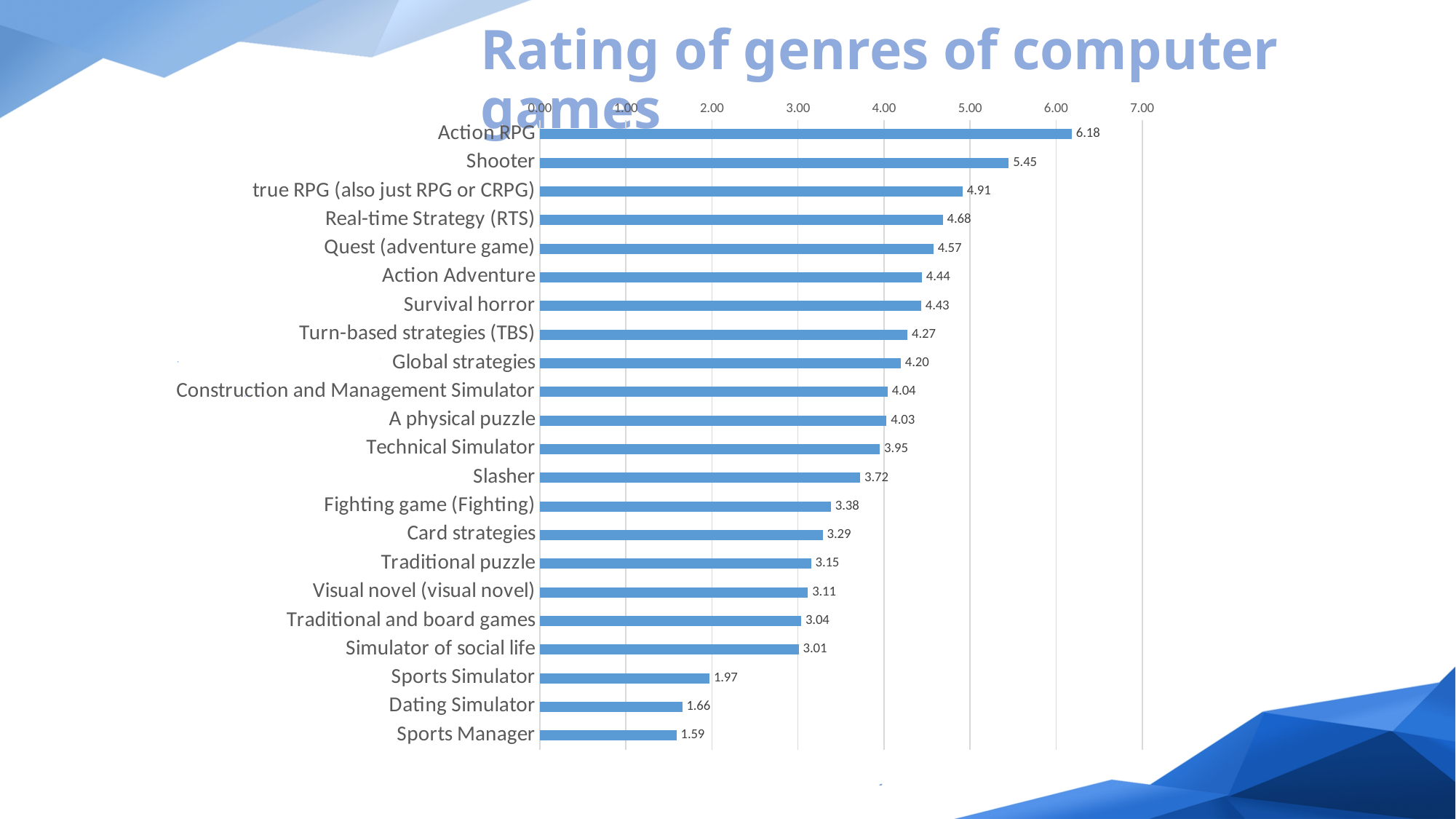
What is the rating for Survival horror? 4.43 Is the rating for Technical Simulator greater or less than 4.00? less What is the title of the chart? Rating of genres of computer games Which has a higher rating, Slasher or Card strategies? Slasher How many genres are shown in the chart? 22 What is the difference between the ratings of Sports Simulator and Sports Manager? 0.38 What is the rating for Shooter? 5.45 Which genre has the highest rating? Action RPG What is the difference between the ratings of Action RPG and Shooter? 0.73 What is the rating for Dating Simulator? 1.66 Which genre has the lowest rating? Sports Manager What kind of chart is shown on the slide? Bar chart